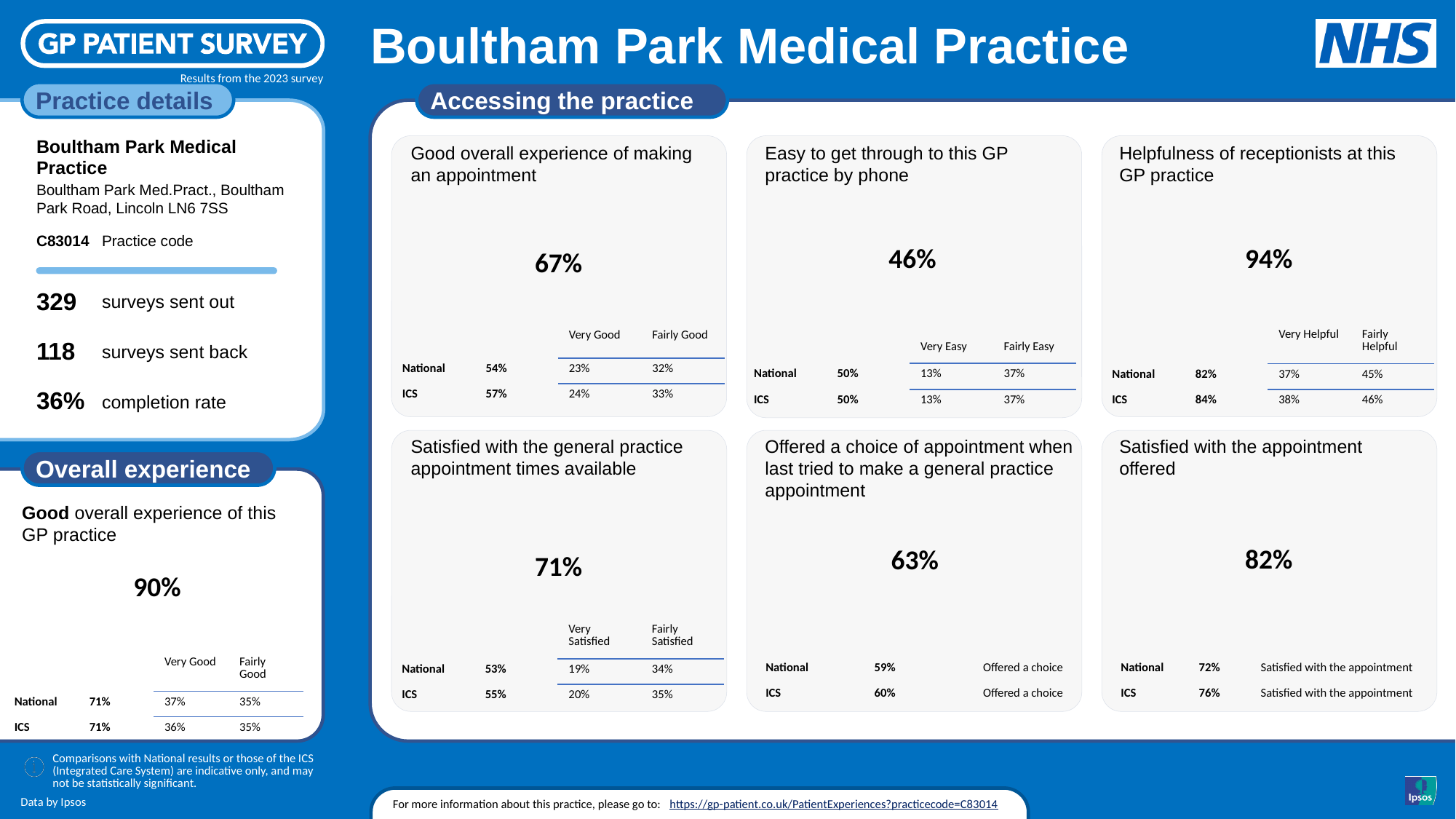
In the 'Good overall experience of this GP practice' panel, what is the practice's headline value? 90% In the 'Helpfulness of receptionists at this GP practice' panel, what is the National value? 82% Across the six 'Accessing the practice' panels, which measure has the lowest practice value? Easy to get through to this GP practice by phone (46%) In the 'Satisfied with the general practice appointment times available' panel, what is the ICS 'Very Satisfied' value? 20% Across the six 'Accessing the practice' panels, which measure has the highest practice value? Helpfulness of receptionists at this GP practice (94%) In the 'Easy to get through to this GP practice by phone' panel, what is the difference between the National 50% and the practice's 46%? 4 percentage points In the 'Helpfulness of receptionists at this GP practice' panel, which is larger: the practice's 94% or the ICS 84%? The practice's 94% In the 'Offered a choice of appointment when last tried to make a general practice appointment' panel, what is the National value? 59% In the 'Easy to get through to this GP practice by phone' panel, what is the practice's headline value? 46% In the 'Good overall experience of making an appointment' panel, what is the practice's headline value? 67% In the 'Satisfied with the appointment offered' panel, what is the ICS value? 76% In the 'Good overall experience of this GP practice' panel, what is the difference between the practice's 90% and the National 71%? 19 percentage points